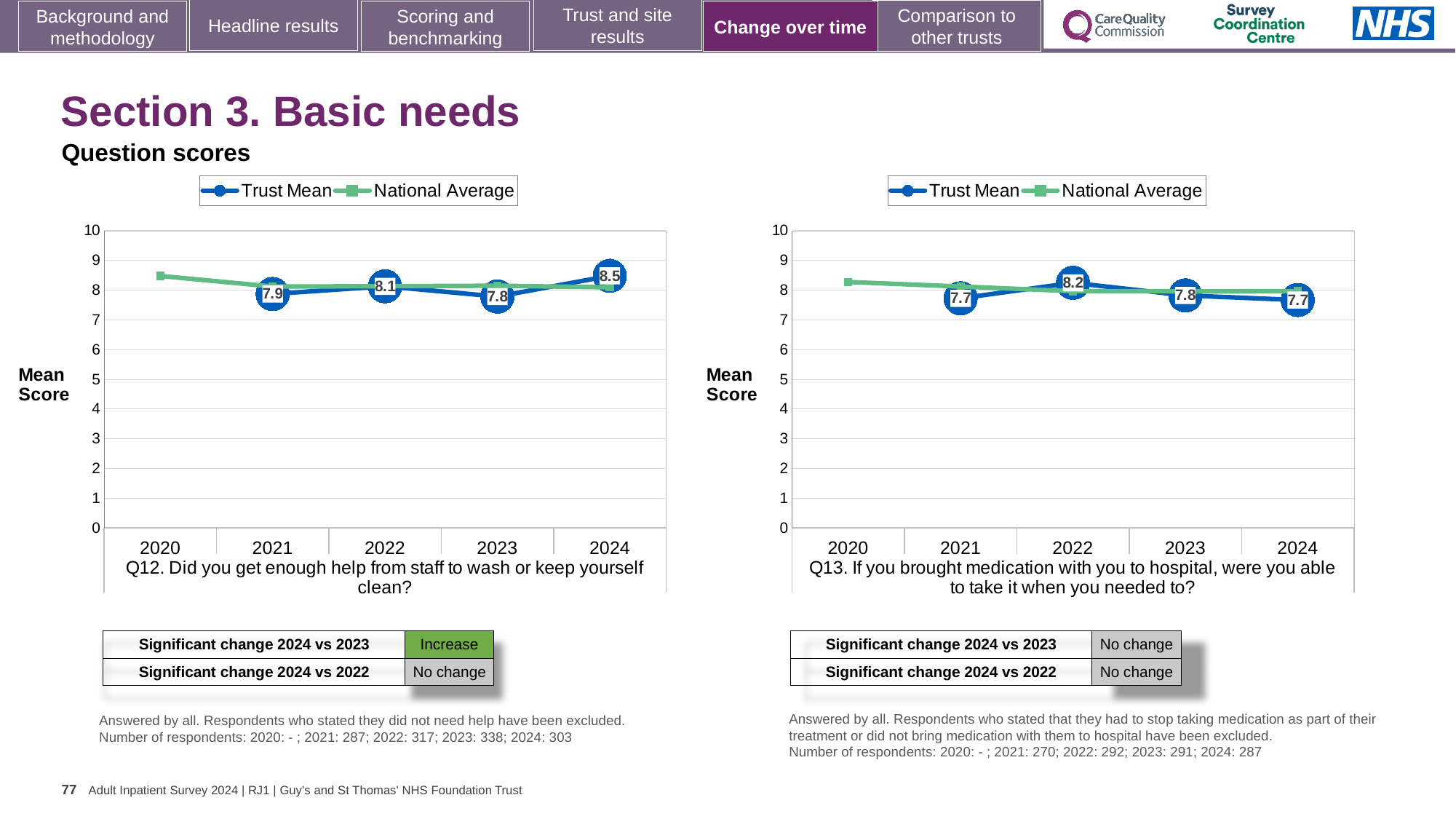
In the Q13 chart (right), which is larger, the Trust Mean for 2022 or for 2024? 2022 In the Q12 chart (left), which year has the highest Trust Mean? 2024 In the Q12 chart (left), is the National Average for 2020 greater or less than 8? greater How many series does the legend of the Q13 chart (right) list? 2 In the Q12 chart (left), what is the difference between the Trust Mean for 2024 and 2023? 0.7 What kind of chart is the Q12 chart (left)? Line chart In the Q12 chart (left), what is the Trust Mean for 2024? 8.5 In the Q13 chart (right), what is the Trust Mean for 2022? 8.2 In the Q12 chart (left), which year has the lowest labelled Trust Mean? 2023 In the Q12 chart (left), what is the Trust Mean for 2023? 7.8 In the Q13 chart (right), which year has the highest Trust Mean? 2022 In the Q13 chart (right), what is the Trust Mean for 2024? 7.7